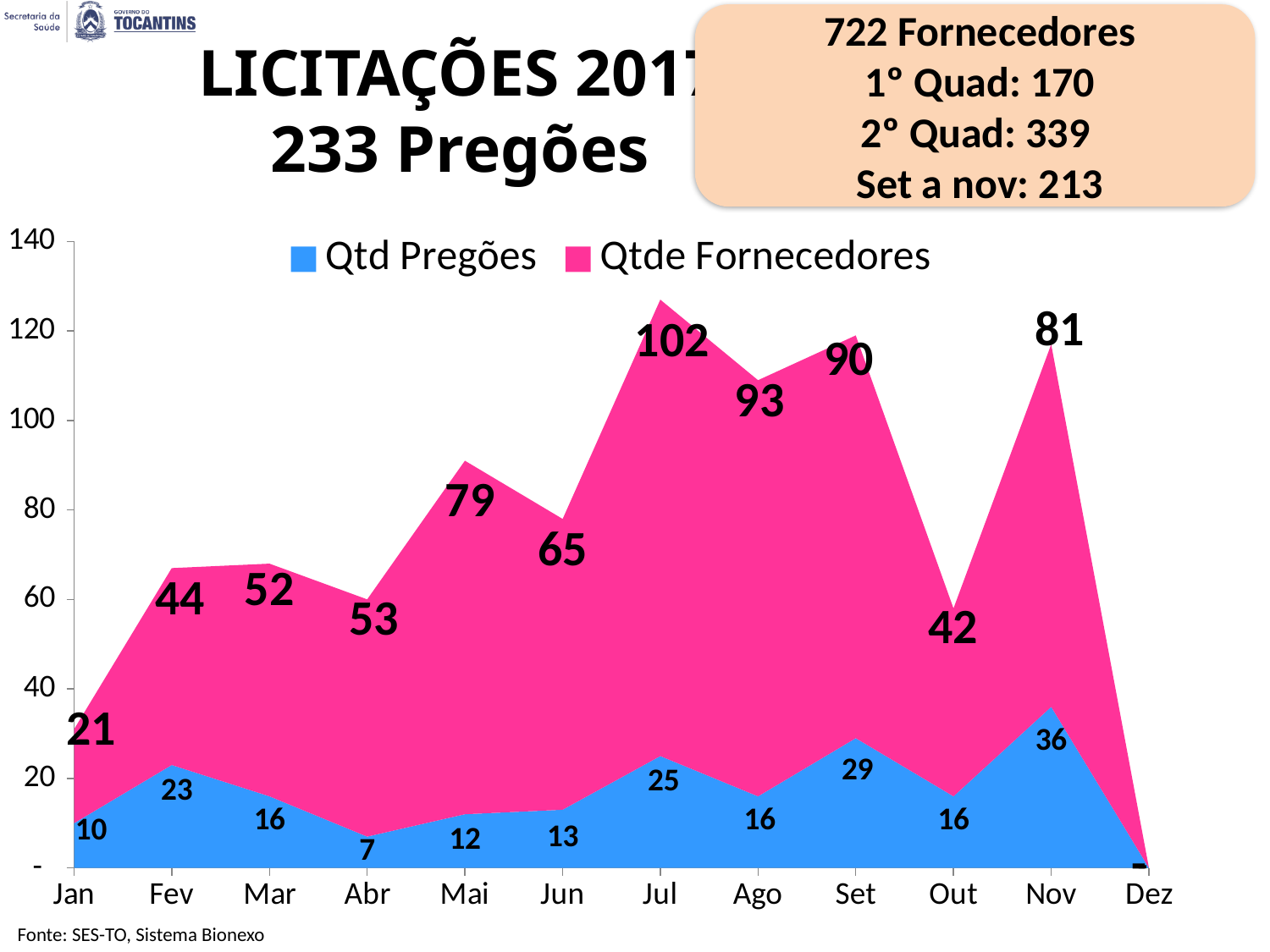
Does the Qtde Fornecedores value rise or fall from Set to Out? Fall How many months are shown on the x axis? 12 Which is larger, the Qtd Pregões value for Set or for Fev? Set What is the difference between the Qtde Fornecedores values for Jul and Out? 60 Which month has the highest value for Qtde Fornecedores? Jul What is the combined total of Qtd Pregões and Qtde Fornecedores for Jan? 31 What kind of chart is shown on the slide? Stacked area chart Which month has the lowest value for Qtd Pregões among Jan to Nov? Abr What is the value of Qtd Pregões for Abr? 7 What is the value of Qtd Pregões for Nov? 36 What is the value of Qtde Fornecedores for Jul? 102 How many series does the legend list? 2